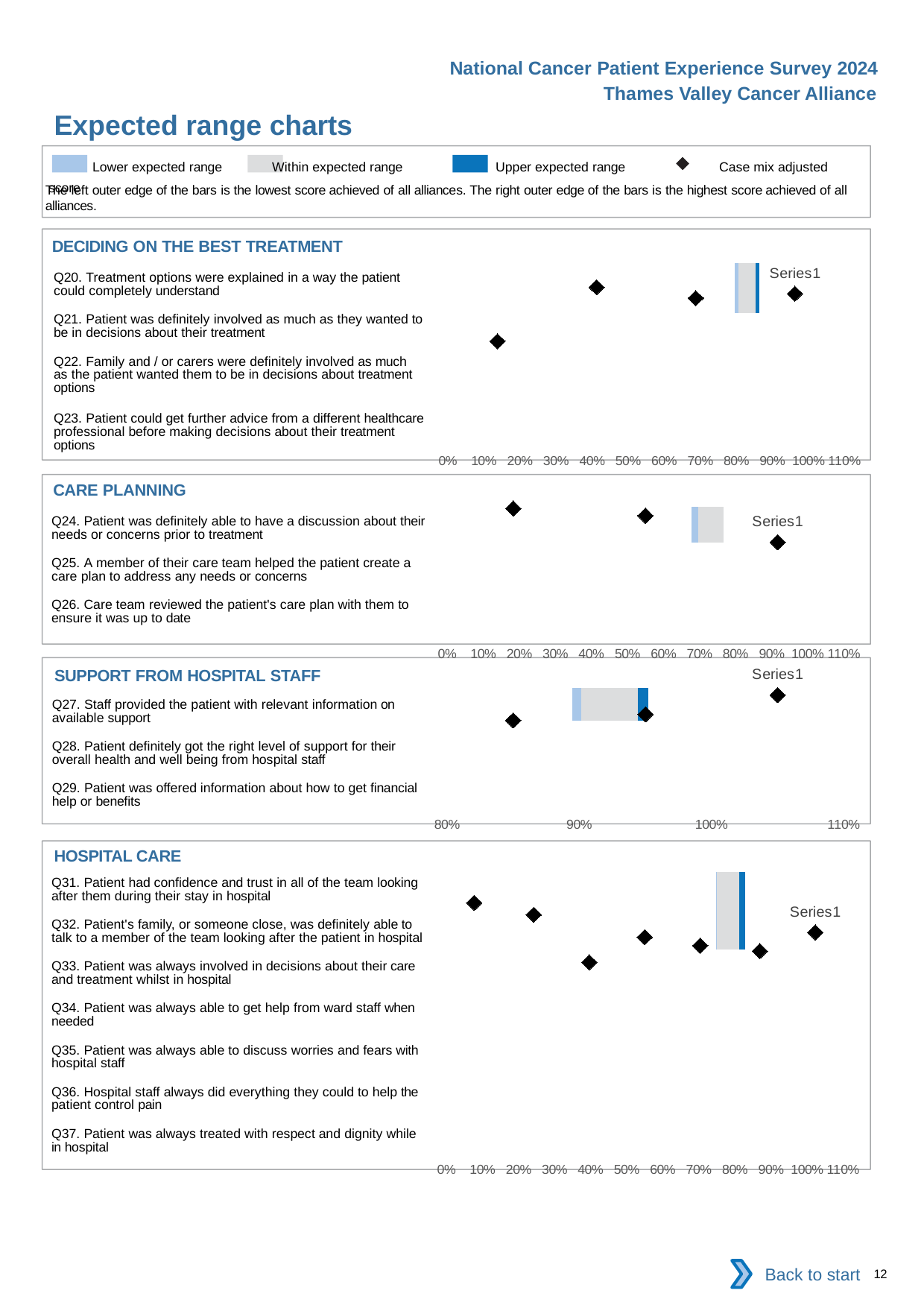
In the SUPPORT FROM HOSPITAL STAFF chart, what is the lowest value shown on the x axis? 80% In the HOSPITAL CARE chart, what is the highest value shown on the x axis? 110% How many chart panels are shown on the slide? 4 How many entries does the legend at the top of the slide list? 4 How many questions are listed in the CARE PLANNING section? 3 What is the title of the slide containing the charts? Expected range charts How many questions (Q31 to Q37) are listed in the HOSPITAL CARE section? 7